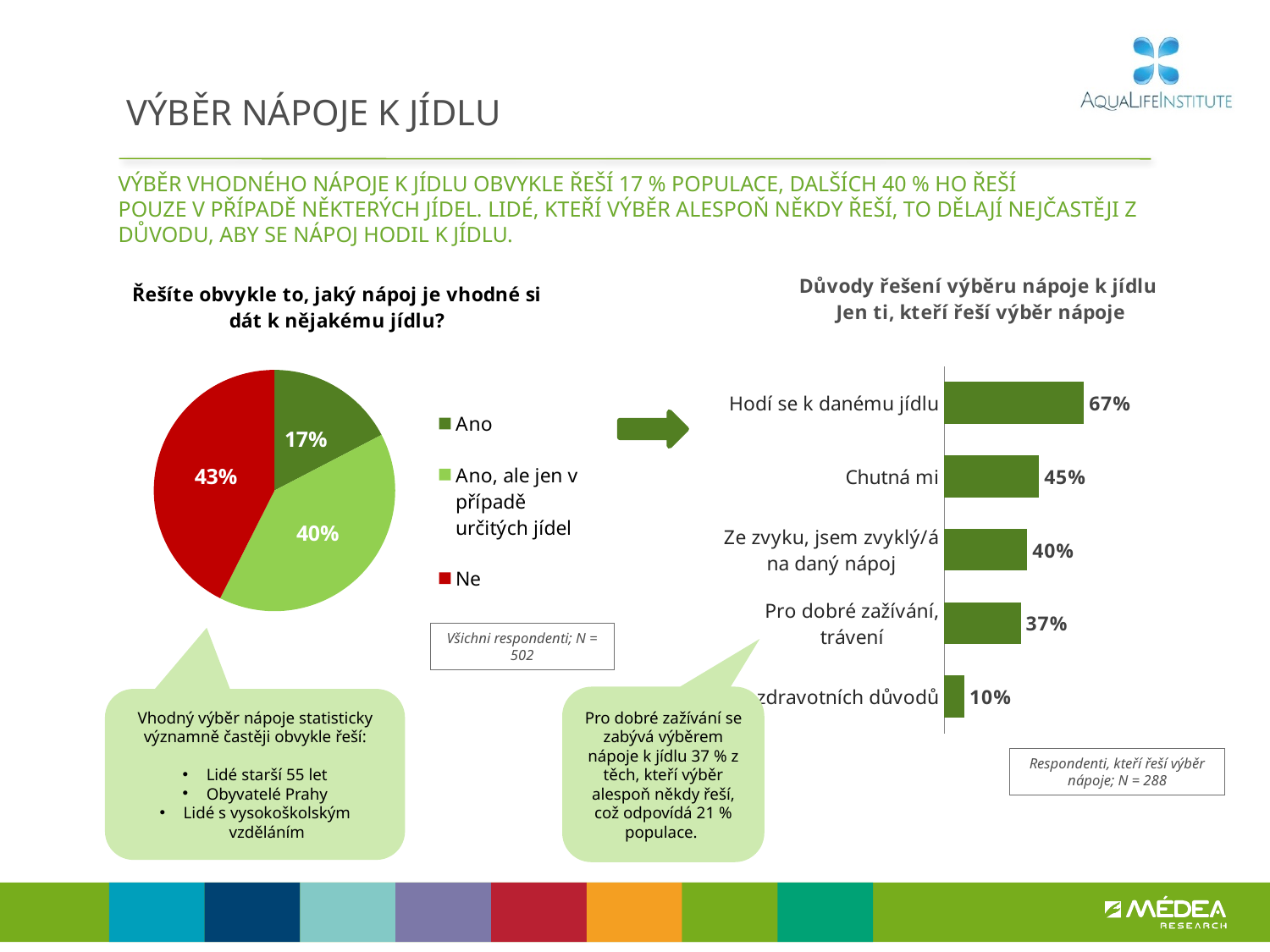
In the pie chart on the left, what share of respondents answered "Ne"? 43% In the chart on the right (Důvody řešení výběru nápoje k jídlu), which reason has the lowest value? zdravotních důvodů What kind of chart is the chart on the right (Důvody řešení výběru nápoje k jídlu)? Bar chart In the pie chart on the left, which answer has the largest slice? Ne In the chart on the right (Důvody řešení výběru nápoje k jídlu), what is the value for "Chutná mi"? 45% In the pie chart on the left, what is the difference in percentage points between "Ne" and "Ano"? 26 percentage points In the pie chart on the left, which answer has the smallest slice? Ano In the chart on the right (Důvody řešení výběru nápoje k jídlu), what is the value for "Hodí se k danému jídlu"? 67% In the chart on the right (Důvody řešení výběru nápoje k jídlu), which is larger: "Ze zvyku, jsem zvyklý/á na daný nápoj" or "Pro dobré zažívání, trávení"? Ze zvyku, jsem zvyklý/á na daný nápoj In the pie chart on the left, what share of respondents answered "Ano"? 17% In the pie chart on the left, how many entries does the legend list? 3 In the chart on the right (Důvody řešení výběru nápoje k jídlu), how many categories are shown? 5